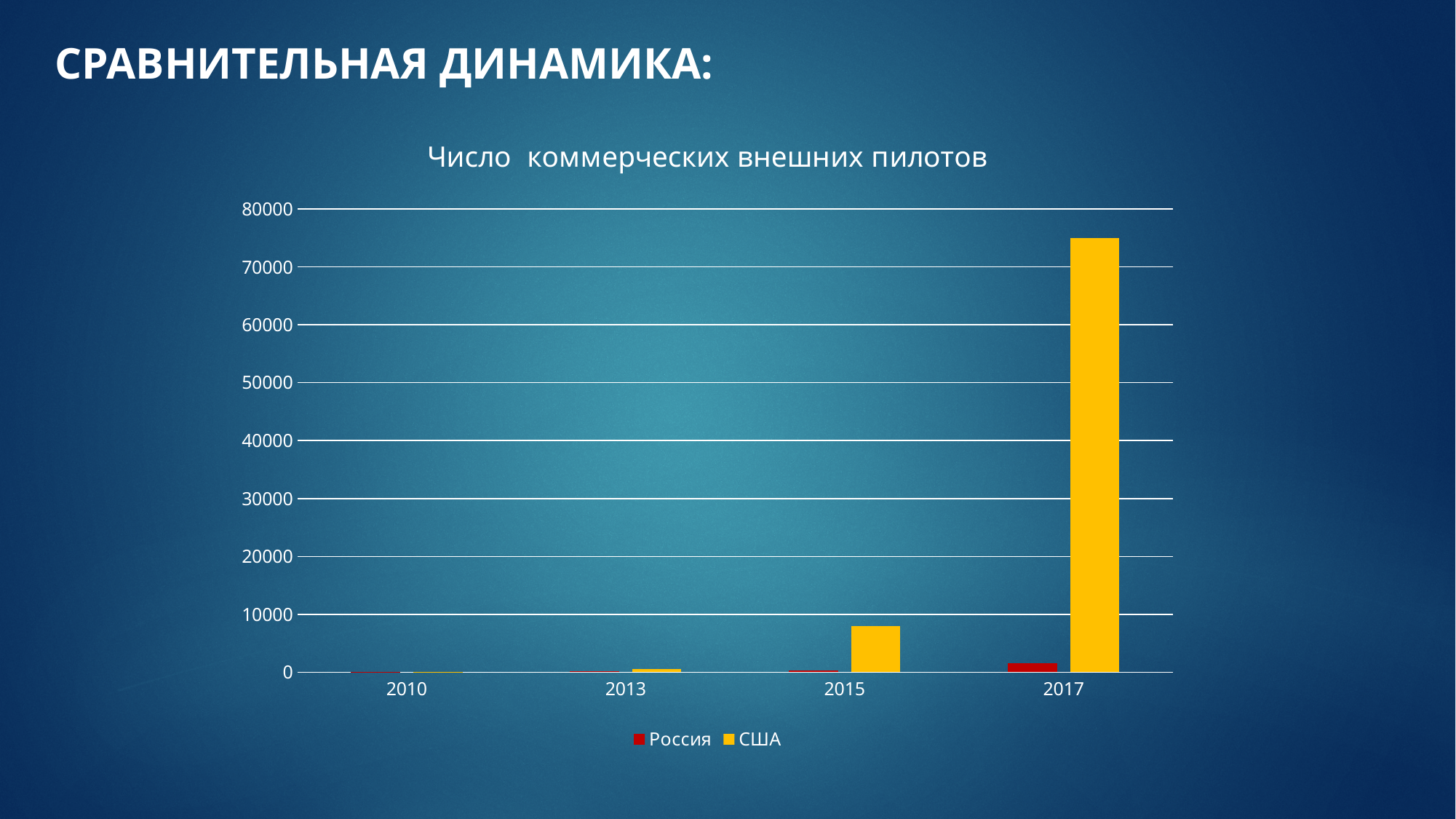
Is the value for Россия in 2017 greater or less than 10000? less Which series is shown in yellow? США Is the value for США in 2017 greater or less than 70000? greater Do the values for США rise or fall from 2010 to 2017? rise How many years are shown on the x axis? 4 What kind of chart is shown on the slide? bar chart Is the value for США in 2015 greater or less than 10000? less Which year has the highest value for США? 2017 How many series does the legend list? 2 What is the title of the chart? Число коммерческих внешних пилотов Which year has the highest value for Россия? 2017 Which is larger in 2017, the value for Россия or the value for США? США